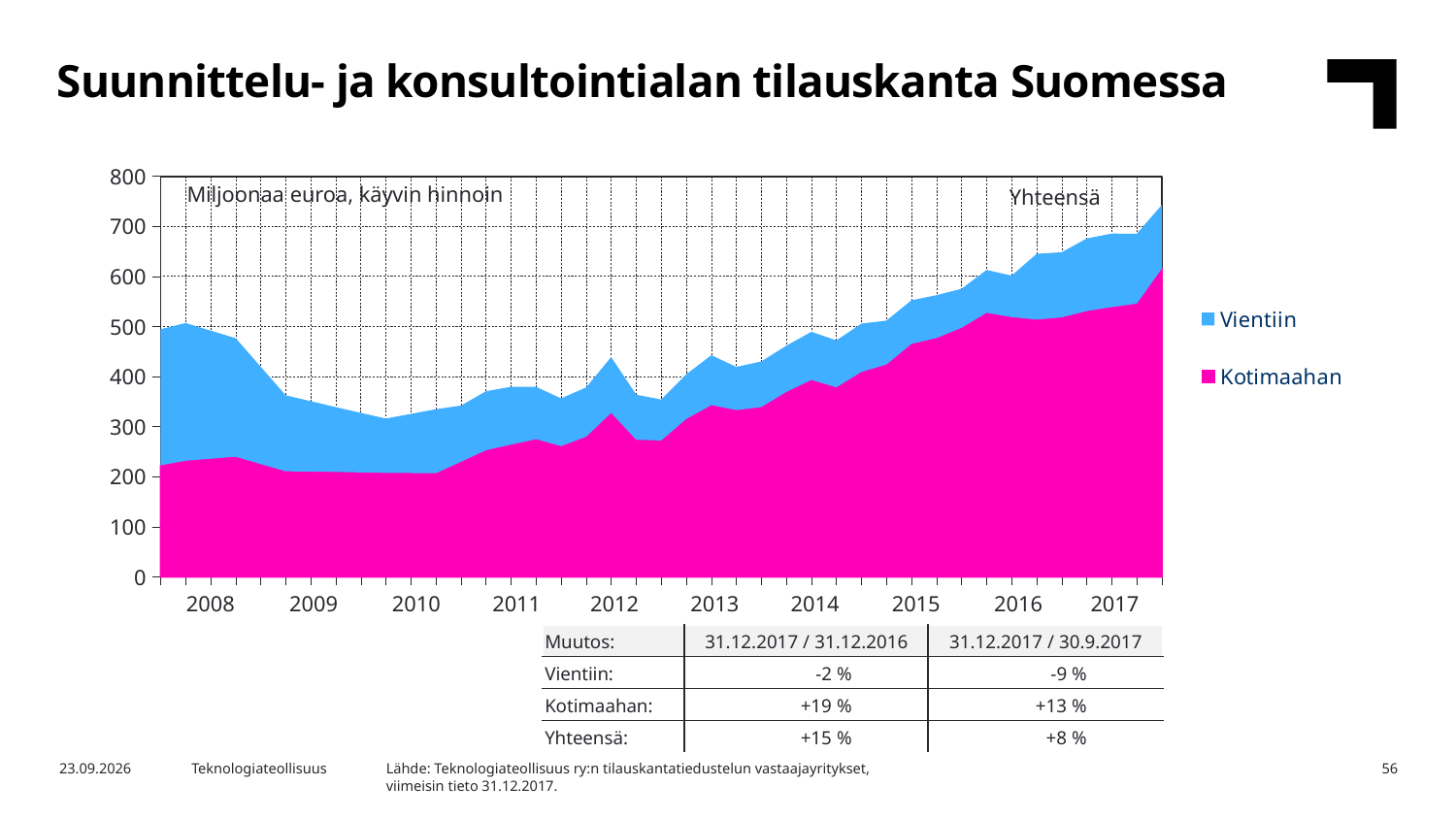
According to the table below the chart, what is the change in Vientiin between 30.9.2017 and 31.12.2017? -9 % Is the total (Yhteensä) value in 2010 greater or less than 400? less Is the Kotimaahan value at the end of 2017 greater or less than 600? greater What unit is stated in the label at the top left of the chart? Miljoonaa euroa, käyvin hinnoin Is the Kotimaahan value in 2010 greater or less than 300? less Does the total order backlog (Yhteensä) rise or fall overall from 2010 to 2017? Rise According to the table below the chart, what is the change in Kotimaahan between 31.12.2016 and 31.12.2017? +19 % How many years are labelled on the x axis of the chart? 10 Which two series are listed in the chart legend? Vientiin and Kotimaahan What kind of chart is shown on the slide? Stacked area chart How many series does the chart legend list? 2